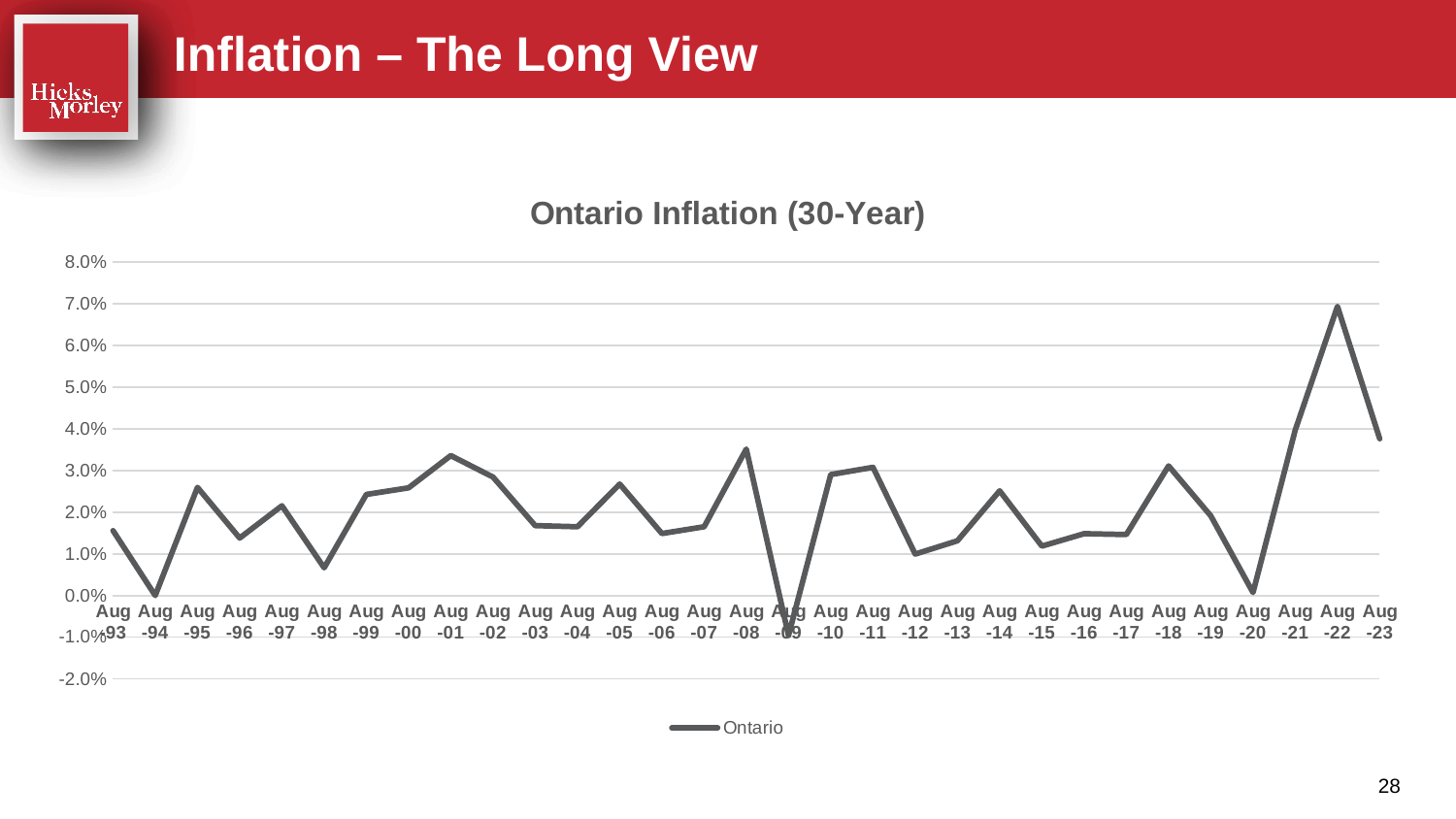
What kind of chart is shown on the slide? Line chart Does the Ontario inflation line rise or fall between Aug-20 and Aug-22? Rise Is the value for Aug-20 greater or less than 1.0%? less Which is larger, the value for Aug-95 or the value for Aug-98? Aug-95 How many series does the legend list? 1 How many data points are plotted along the x axis? 31 In which year does the Ontario inflation line reach its highest value? Aug-22 What is the name of the series shown in the legend? Ontario In which year does the Ontario inflation line reach its lowest value? Aug-09 Is the value for Aug-23 greater or less than 3.0%? greater What is the title of the chart? Ontario Inflation (30-Year) Is the value for Aug-22 greater or less than 6.0%? greater